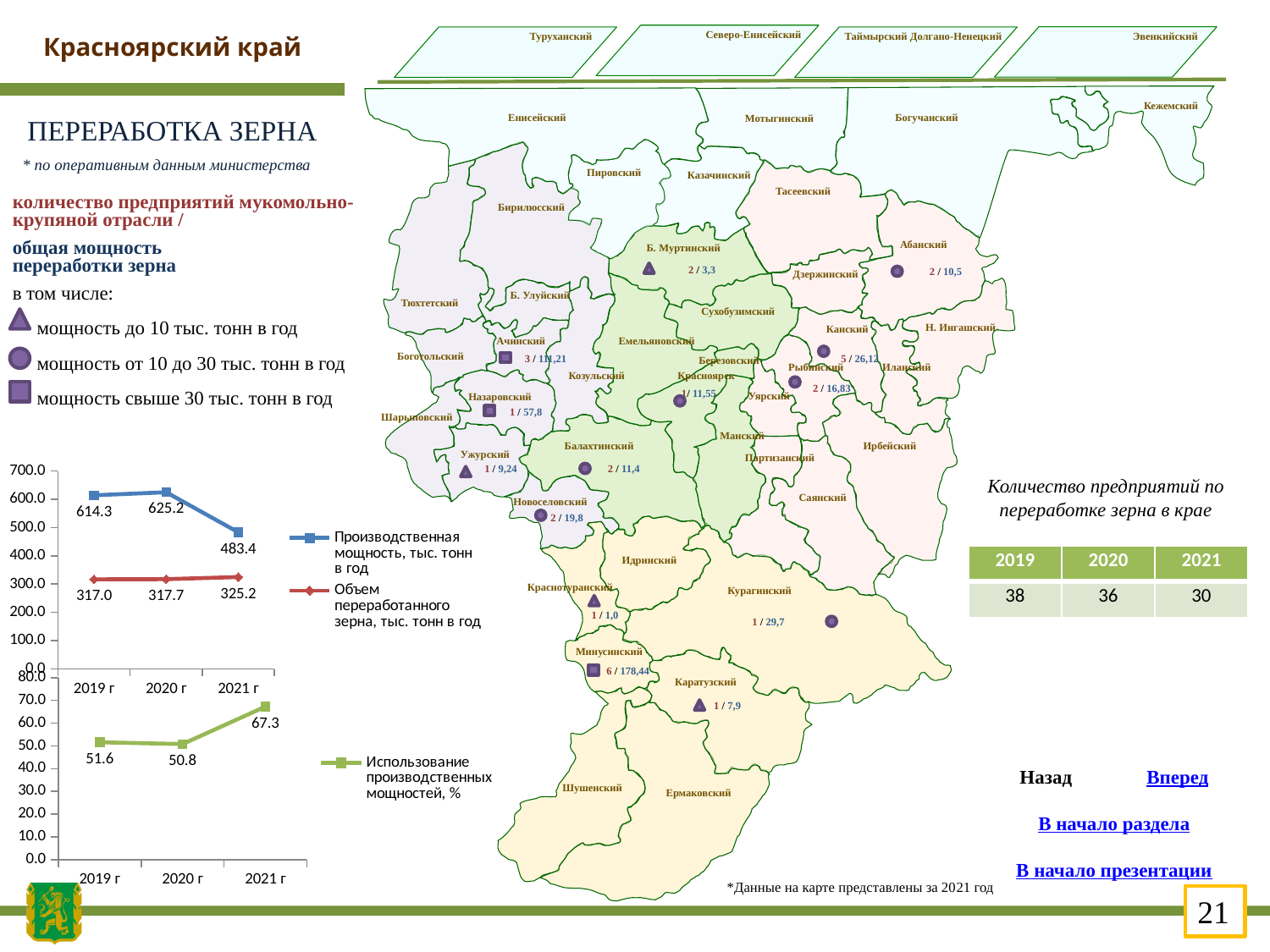
In the upper line chart, what is the value of Объем переработанного зерна, тыс. тонн в год for 2019 г? 317.0 What kind of chart is the lower chart showing Использование производственных мощностей, %? line chart How many series does the legend of the upper line chart list? 2 How many years are plotted on the x axis of the lower line chart? 3 In the lower line chart, in which year is Использование производственных мощностей, % lowest? 2020 г In the lower line chart, what is the value of Использование производственных мощностей, % for 2021 г? 67.3 In the upper line chart, what is the difference between Производственная мощность in 2020 г and in 2021 г? 141.8 In the lower line chart, what is the difference between the values for 2021 г and 2019 г? 15.7 In the upper line chart, in which year is Производственная мощность, тыс. тонн в год highest? 2020 г In the upper line chart, in which year is Объем переработанного зерна, тыс. тонн в год lowest? 2019 г In the upper line chart, which is larger in 2021 г: Производственная мощность or Объем переработанного зерна? Производственная мощность In the upper line chart, what is the value of Производственная мощность, тыс. тонн в год for 2021 г? 483.4